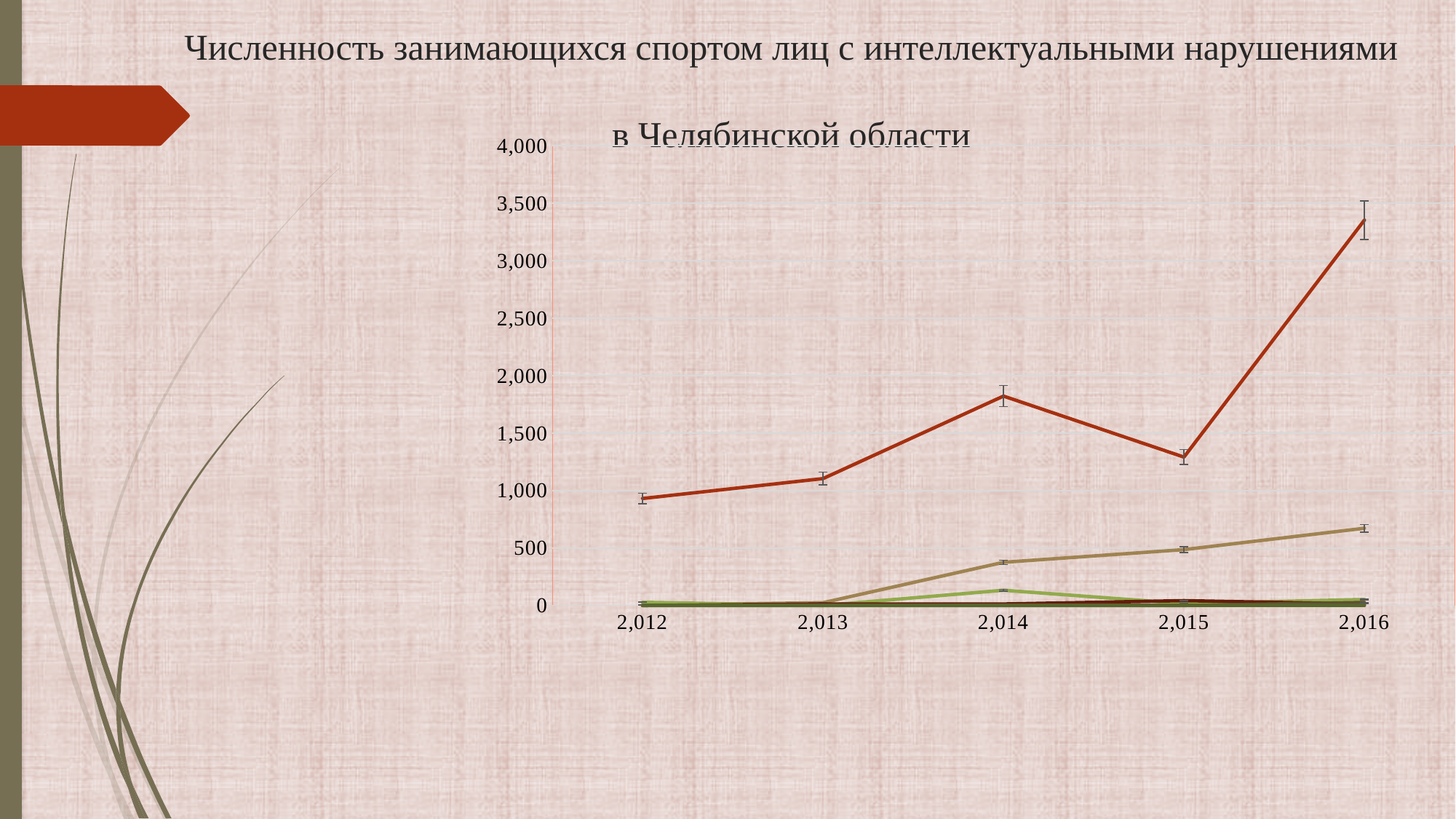
In which year does the red line have its lowest value? 2,012 Does the red line rise or fall between 2,015 and 2,016? rise What is the title of the chart? Численность занимающихся спортом лиц с интеллектуальными нарушениями в Челябинской области For the red line, which year has the larger value, 2,014 or 2,015? 2,014 Is the value of the red line for 2,016 greater or less than 3,000? greater Is the value of the tan line for 2,016 greater or less than 500? greater In which year does the red line reach its highest value? 2,016 Is the value of the red line for 2,014 greater or less than 2,000? less What is the highest value shown on the y axis of the chart? 4,000 How many years are shown along the x axis of the chart? 5 What kind of chart is shown on the slide? line chart